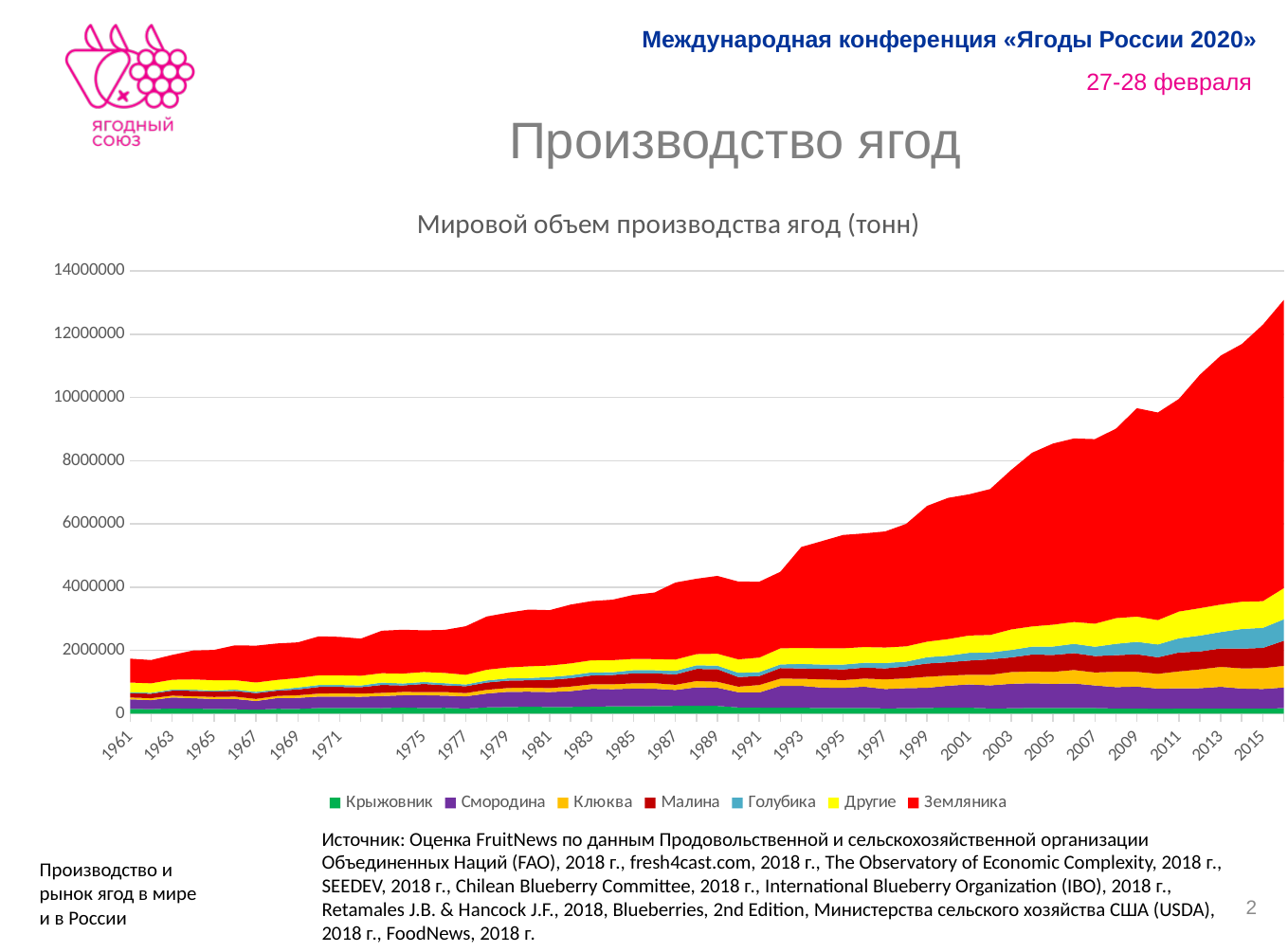
What is the first year shown on the x axis? 1961 Is the total production in 2001 greater or less than 6000000? greater Is the total production in 1991 greater or less than 6000000? less Is the total production in 1961 greater or less than 2000000? less What is the title of the chart? Мировой объем производства ягод (тонн) Does the total world berry production rise or fall from 1961 to the end of the series? Rises What is the highest value labelled on the y axis? 14000000 Which series accounts for the largest share of production throughout the chart? Земляника Which series is shown in red? Земляника How many series does the legend list? 7 What kind of chart is shown on the slide? Stacked area chart